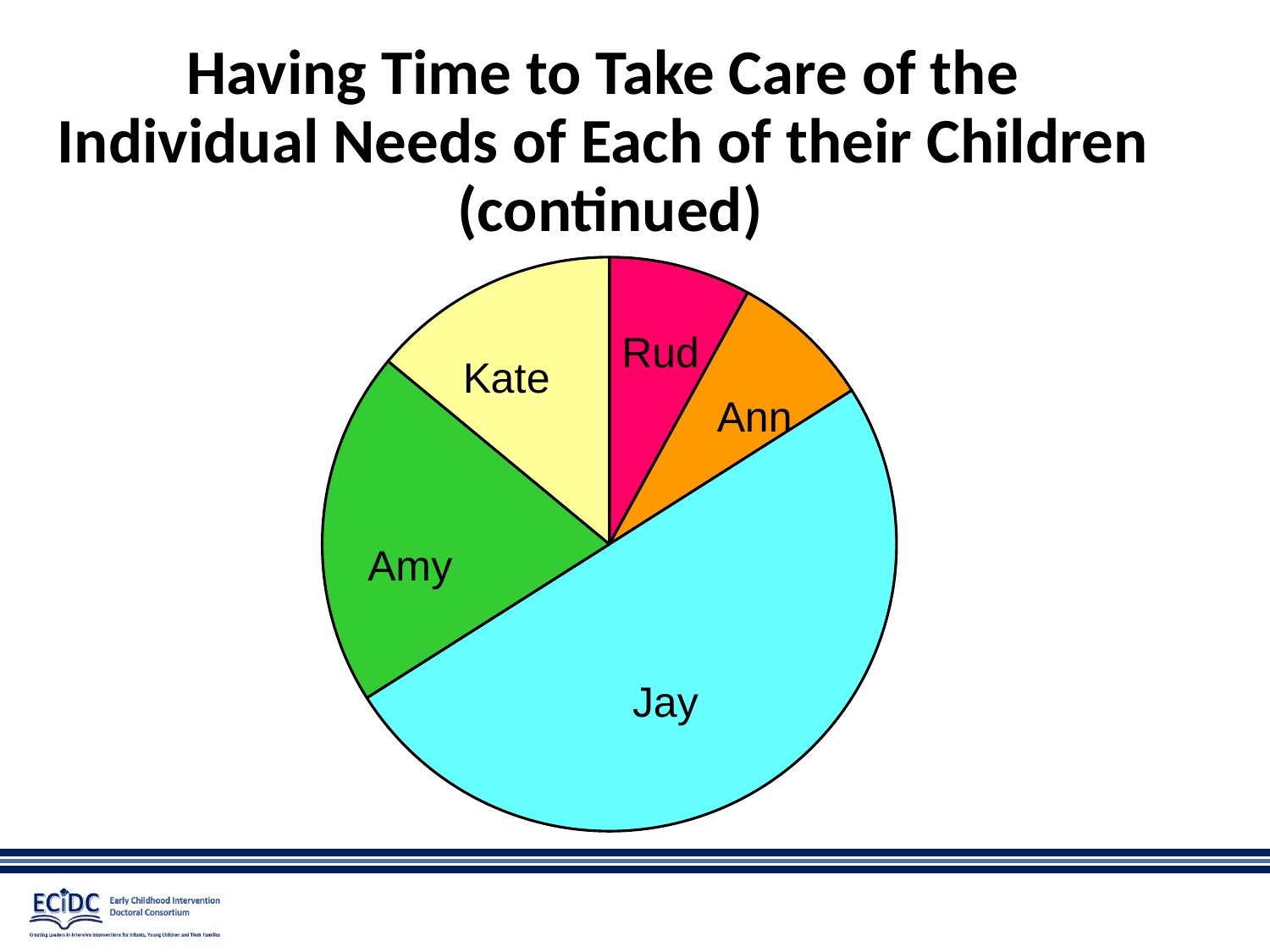
Which is larger, the slice for Jay or the slice for Kate? Jay How many slices does the pie chart have? 5 Which slice of the pie chart is the largest? Jay Which is larger, the slice for Kate or the slice for Ann? Kate What is the title of the slide containing the pie chart? Having Time to Take Care of the Individual Needs of Each of their Children (continued) Which is larger, the slice for Amy or the slice for Rud? Amy What colour is the slice labelled Jay? light blue What kind of chart is shown on the slide? pie chart